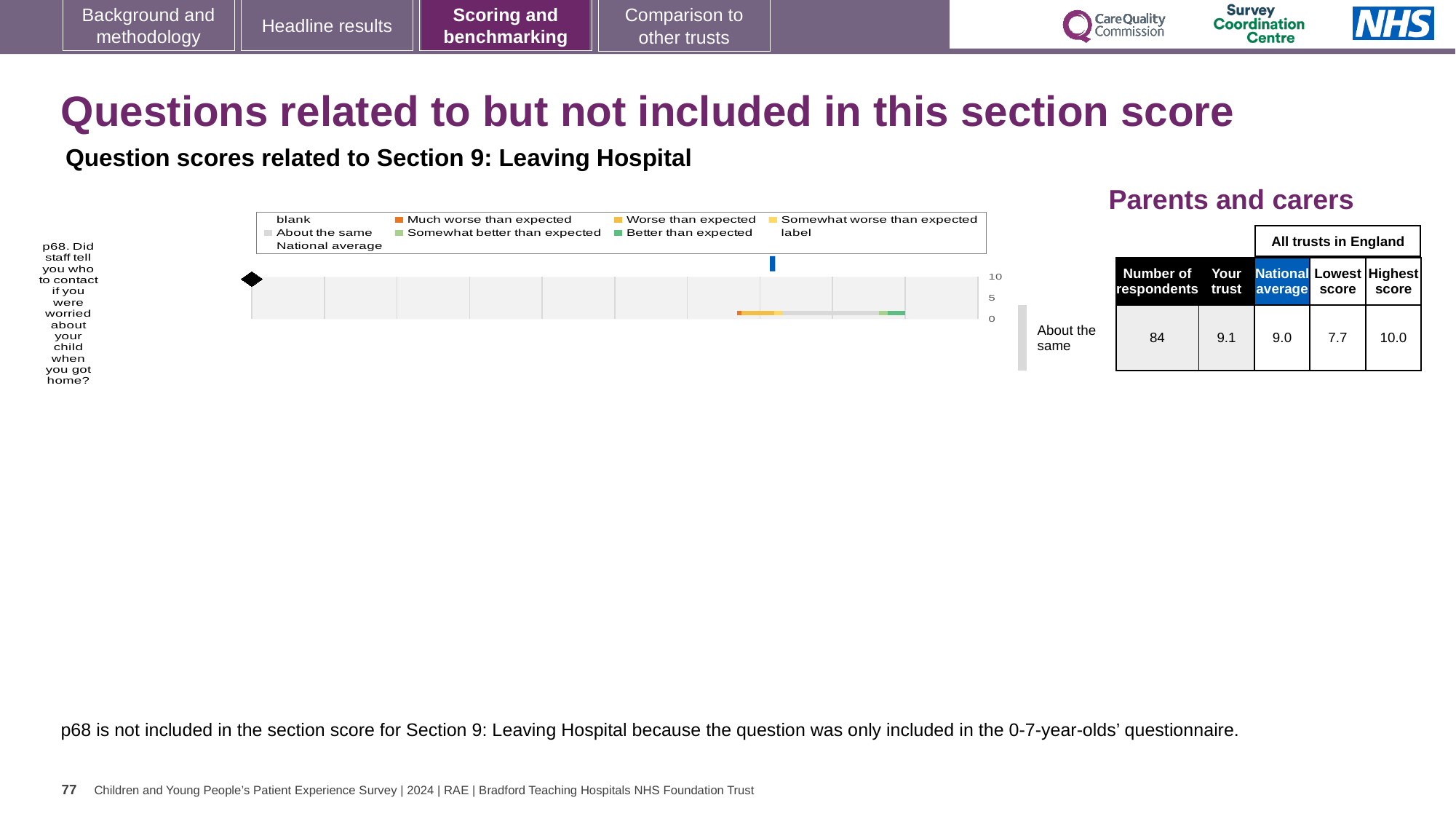
Which respondent group does the chart and table refer to? Parents and carers What kind of chart is used to show the p68 question score? bar chart How is the trust's result for question p68 categorised relative to expectation? About the same Is the 'Your trust' score for question p68 greater or less than 5? greater What is the lowest score among all trusts in England for question p68? 7.7 Which is larger for question p68: the 'Your trust' score or the national average? Your trust What is the difference between the highest and lowest trust scores for question p68? 2.3 How many questions are plotted in the chart? 1 What is the highest score among all trusts in England for question p68? 10.0 What is the national average score for question p68? 9.0 What is the 'Your trust' score for question p68? 9.1 How many respondents answered question p68? 84